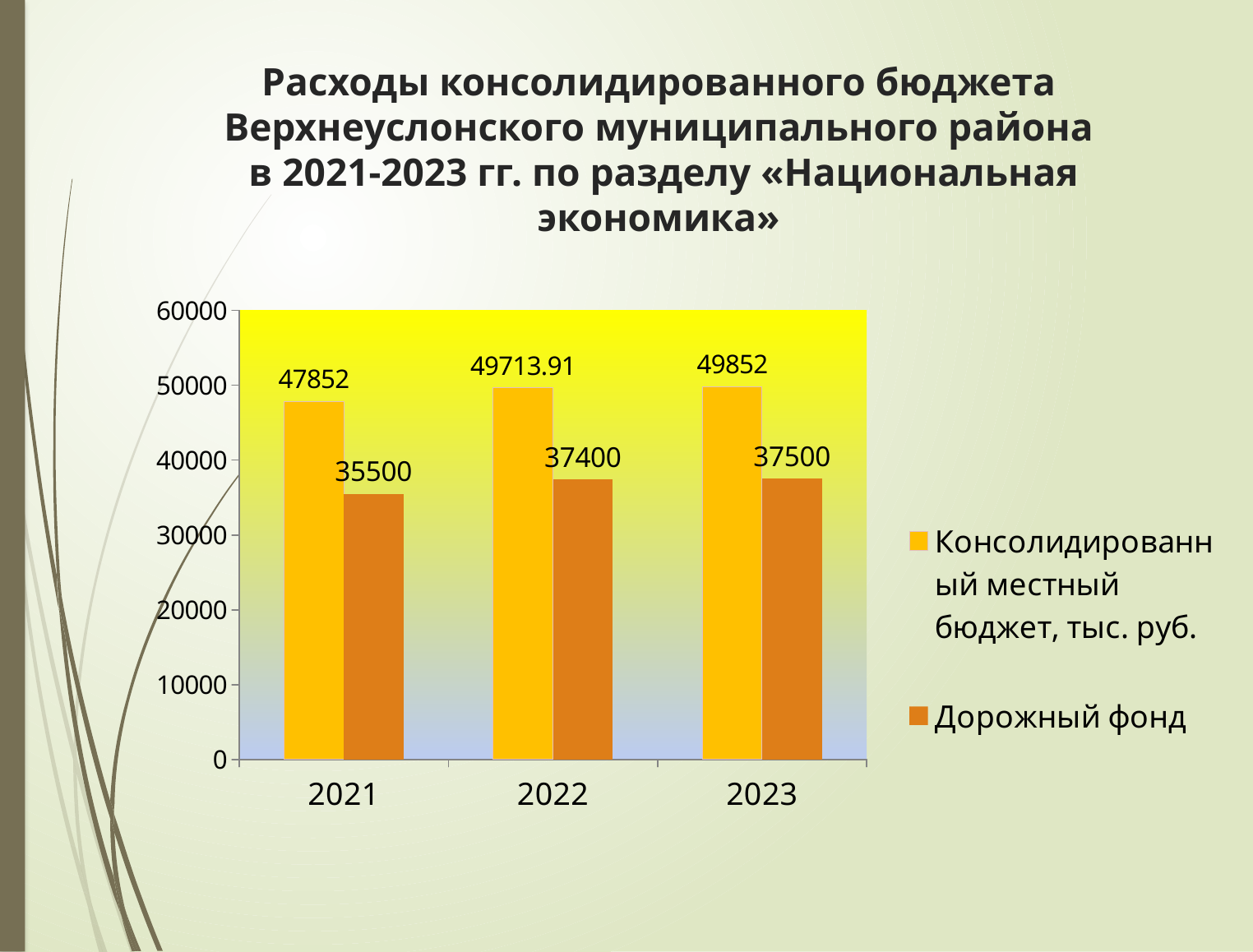
What is the value of the consolidated local budget for 2022? 49713.91 What is the value of the consolidated local budget (Консолидированный местный бюджет) for 2021? 47852 In which year is the road fund (Дорожный фонд) value the lowest? 2021 How many years are shown on the x axis of the chart? 3 By how much did the road fund increase from 2021 to 2023? 2000 How many series does the legend list? 2 What is the value of the road fund (Дорожный фонд) for 2022? 37400 What kind of chart is shown on the slide? bar chart Is the road fund value for 2021 greater or less than 40000? less What is the difference between the consolidated local budget and the road fund in 2023? 12352 In which year is the consolidated local budget value the highest? 2023 Which is larger in 2022: the consolidated local budget or the road fund? Консолидированный местный бюджет